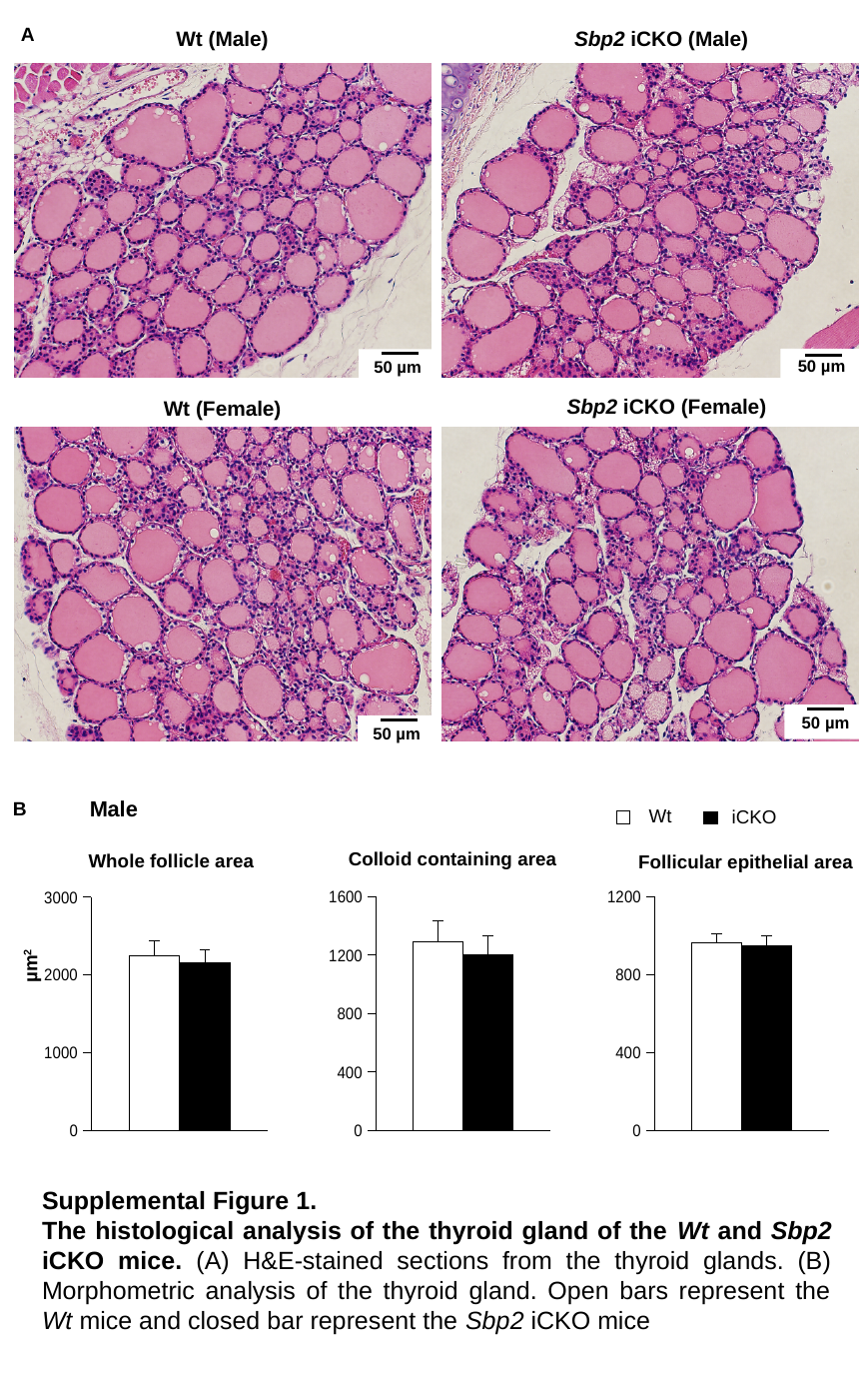
What unit is shown on the y-axis of the 'Whole follicle area' chart? µm² How many series does the legend in panel B list? 2 What kind of chart is the 'Whole follicle area' chart? bar chart In the 'Follicular epithelial area' chart, is the value for iCKO greater or less than 1200? less In the 'Whole follicle area' chart, is the value for Wt greater or less than 2000? greater In the 'Whole follicle area' chart, is the value for iCKO greater or less than 3000? less How many bars are plotted in the 'Colloid containing area' chart? 2 In the 'Colloid containing area' chart, which bar is taller, Wt or iCKO? Wt According to the legend in panel B, which group is represented by the black (closed) bars? iCKO